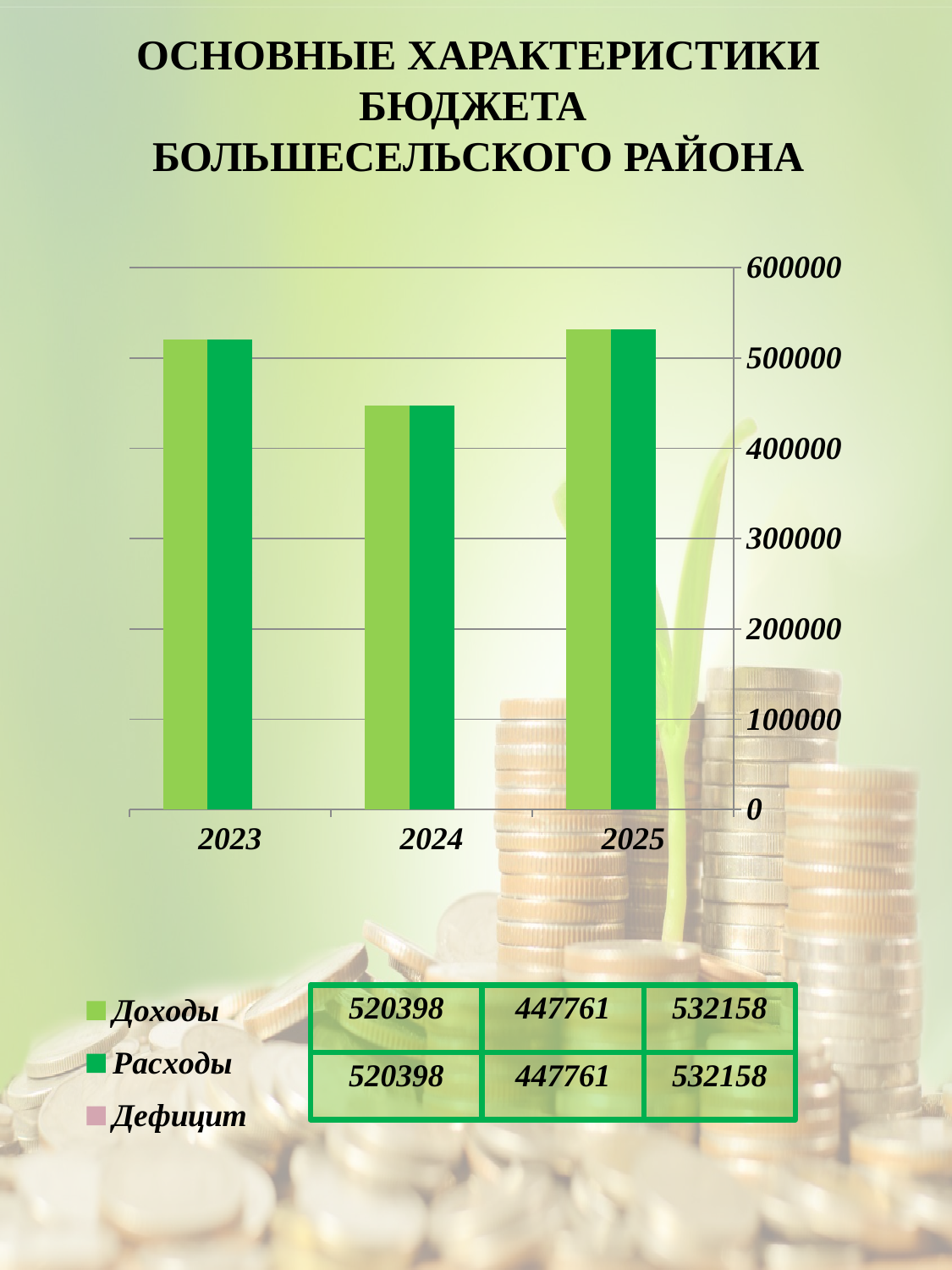
Which year has the highest value for Доходы? 2025 How many years are shown on the x axis? 3 What is the difference between Доходы in 2025 and Доходы in 2024? 84397 Is the value for Расходы in 2024 greater or less than 500000? less What is the value of Доходы for 2023? 520398 What is the value of Расходы for 2025? 532158 What is the difference between Расходы in 2023 and Расходы in 2024? 72637 Which is larger: Доходы in 2023 or Доходы in 2025? 2025 Which year has the lowest value for Расходы? 2024 What is the value of Доходы for 2024? 447761 How many series does the legend list? 3 What kind of chart is shown on the slide? bar chart